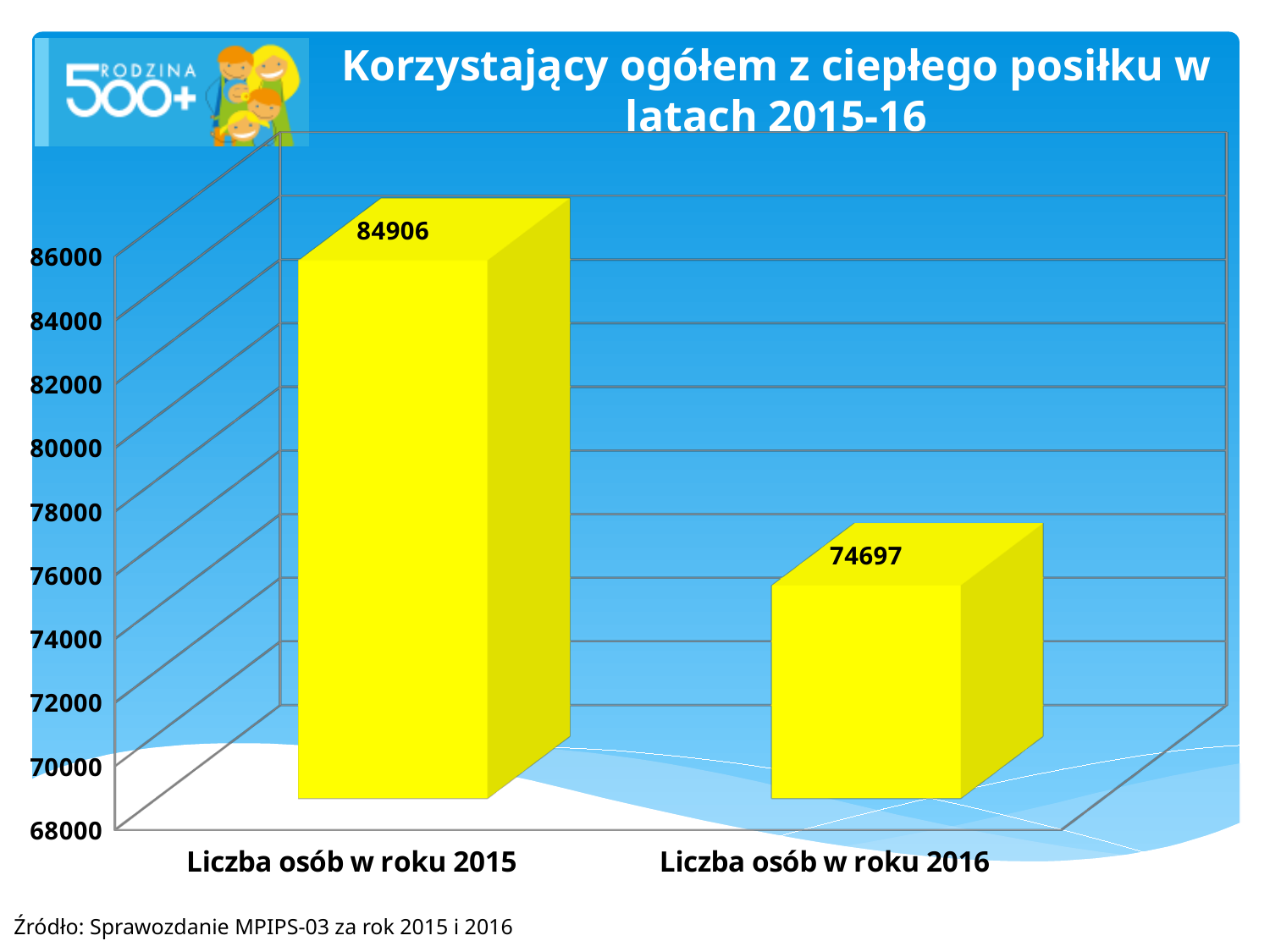
Which category has the lowest value? Liczba osób w roku 2016 What is the title of the chart? Korzystający ogółem z ciepłego posiłku w latach 2015-16 Is the value for Liczba osób w roku 2015 greater or less than 80000? greater What kind of chart is shown on the slide? bar chart How many categories are shown on the chart? 2 What is the difference between the values for 2015 and 2016? 10209 What is the value for Liczba osób w roku 2015? 84906 Do the values rise or fall from 2015 to 2016? fall What is the value for Liczba osób w roku 2016? 74697 Which is larger, the value for Liczba osób w roku 2015 or Liczba osób w roku 2016? Liczba osób w roku 2015 Which category has the highest value? Liczba osób w roku 2015 Is the value for Liczba osób w roku 2016 greater or less than 76000? less